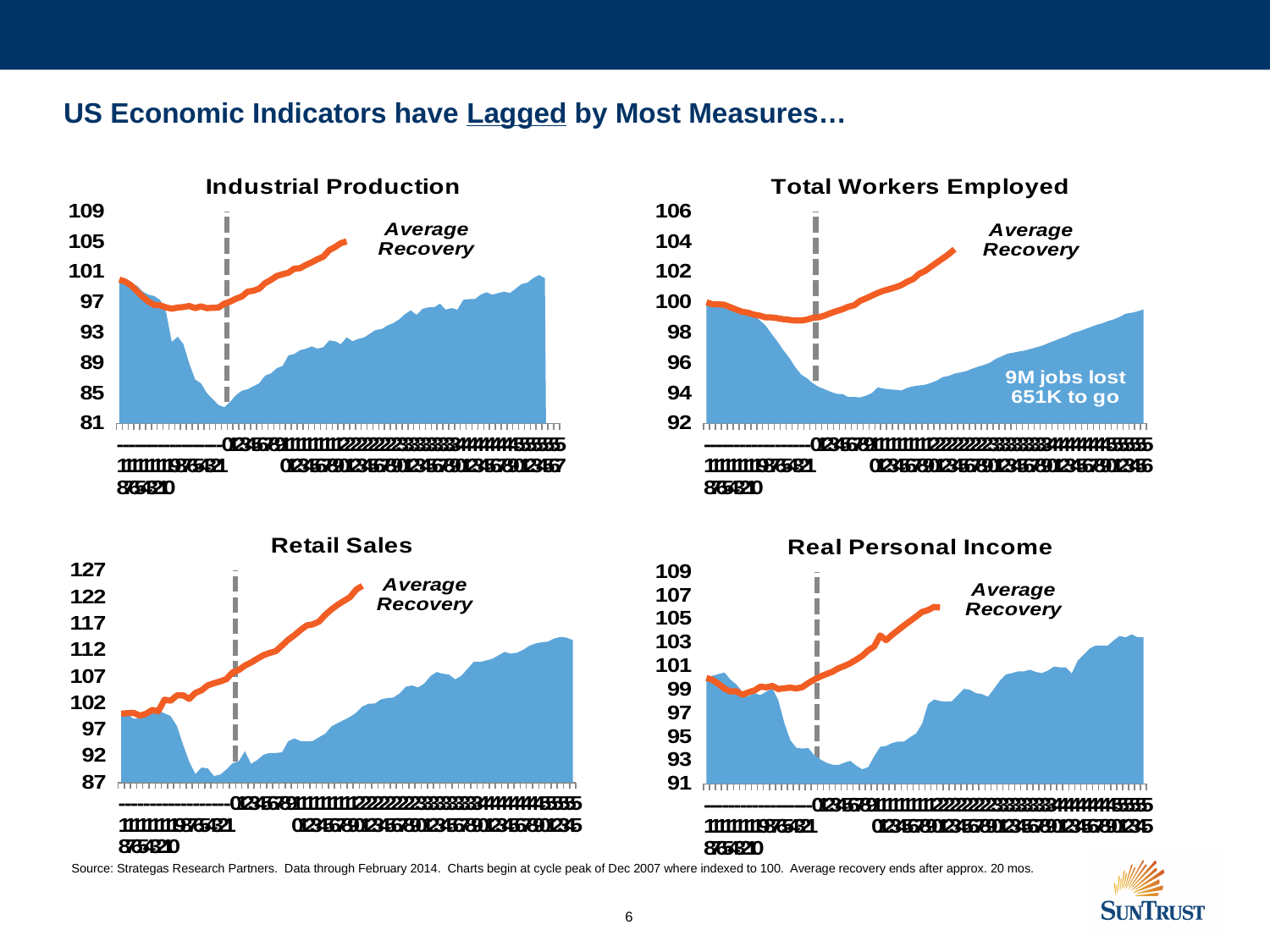
In the Retail Sales chart, is the final value of the blue area greater or less than 112? greater In the Industrial Production chart, is the lowest point of the blue area greater or less than 85? less In the Real Personal Income chart, is the lowest point of the blue area greater or less than 95? less In the Retail Sales chart, does the Average Recovery line rise or fall from left to right? rises In the Real Personal Income chart, does the blue area rise or fall over the first part of the period, before its lowest point? falls In the Industrial Production chart, does the blue area rise or fall after its lowest point? rises What annotation text is printed inside the Total Workers Employed chart? 9M jobs lost 651K to go What kind of chart is the Industrial Production chart? area and line chart What label is given to the orange line in each of the four charts? Average Recovery How many charts are shown on the slide? 4